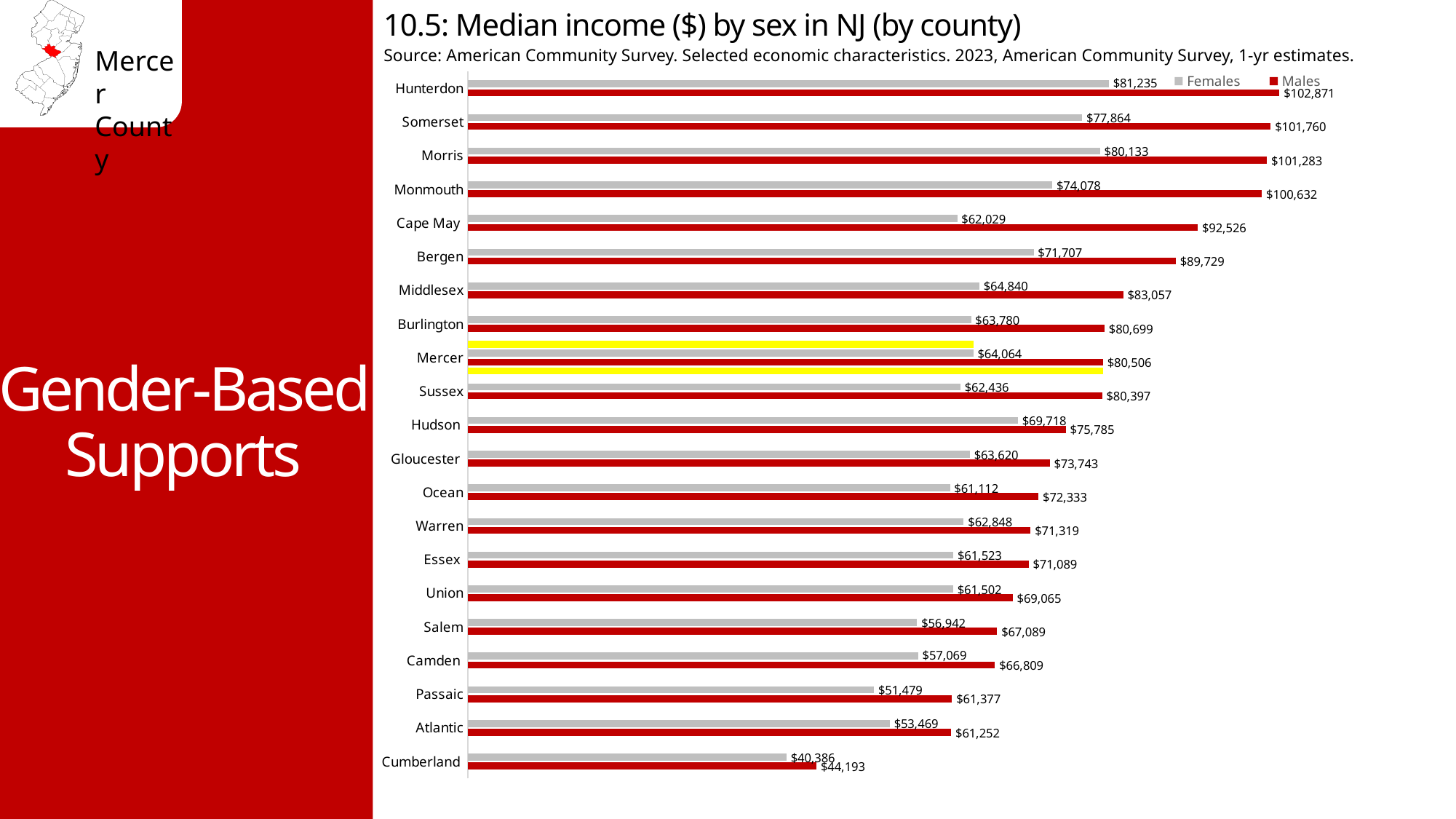
Which county has the highest median income for males? Hunterdon What is the median income for males in Cape May County? $92,526 Which county has the lowest median income for females? Cumberland What is the median income for females in Mercer County? $64,064 How many counties are shown in the chart? 21 What is the median income for females in Hunterdon County? $81,235 What is the difference between male and female median income in Cumberland County? $3,807 What type of chart is shown on the slide? Bar chart What is the median income for males in Mercer County? $80,506 How many series does the legend list? 2 What is the difference between male and female median income in Mercer County? $16,442 Which is larger, the female median income in Hudson County or in Bergen County? Bergen County